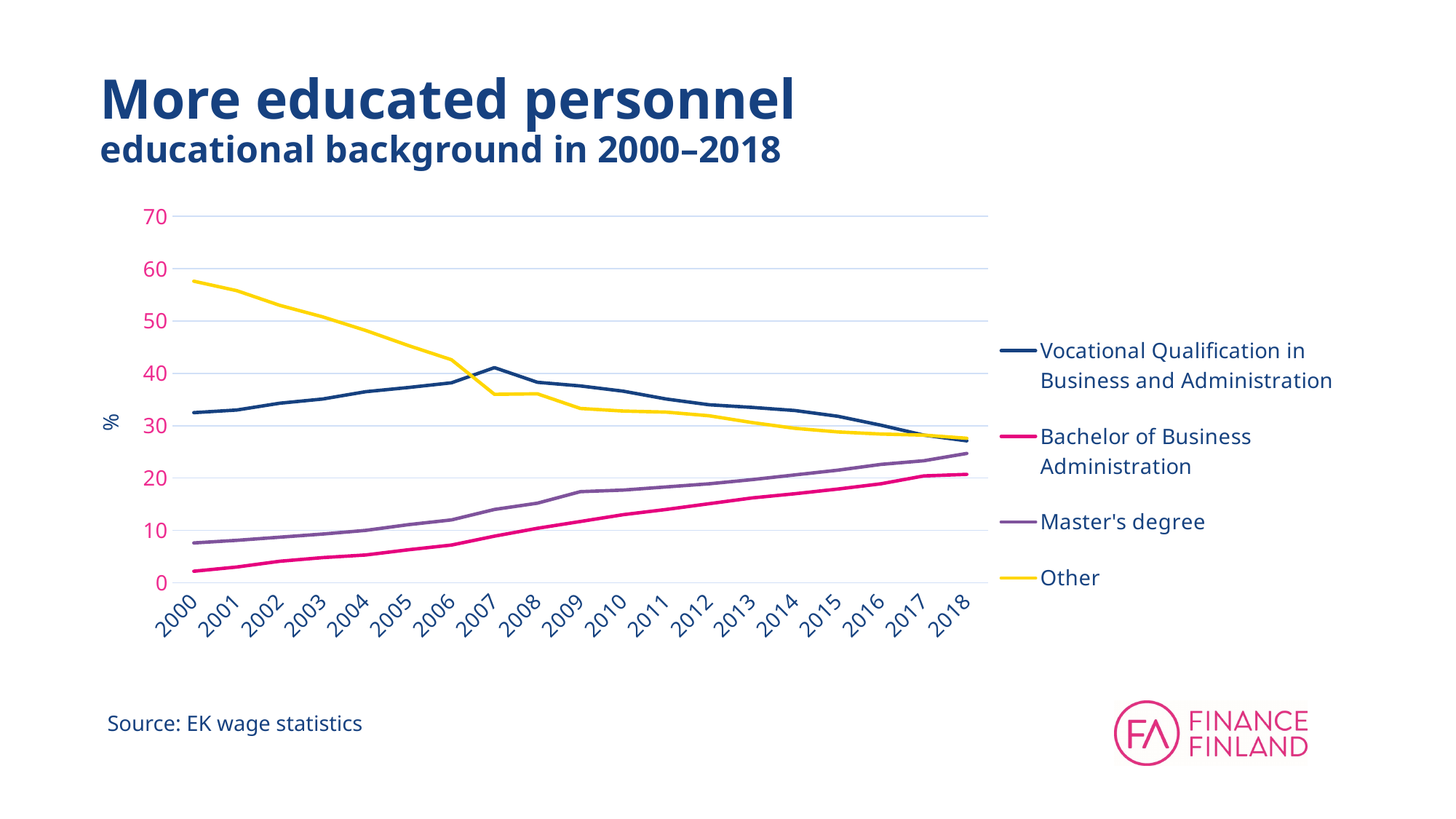
What kind of chart is shown on the slide? line chart Does the value for Bachelor of Business Administration rise or fall from 2000 to 2018? rise Is the value for Bachelor of Business Administration in 2000 greater or less than 10? less Which series has the highest value in 2000? Other How many series does the legend list? 4 Is the value for Other in 2000 greater or less than 50? greater Is the value for Master's degree in 2018 greater or less than 20? greater Which series has the lowest value in 2018? Bachelor of Business Administration Does the value for Other rise or fall from 2000 to 2018? fall What source is cited for the chart data? EK wage statistics How many years are shown on the x axis? 19 In 2000, which is larger: Other or Vocational Qualification in Business and Administration? Other